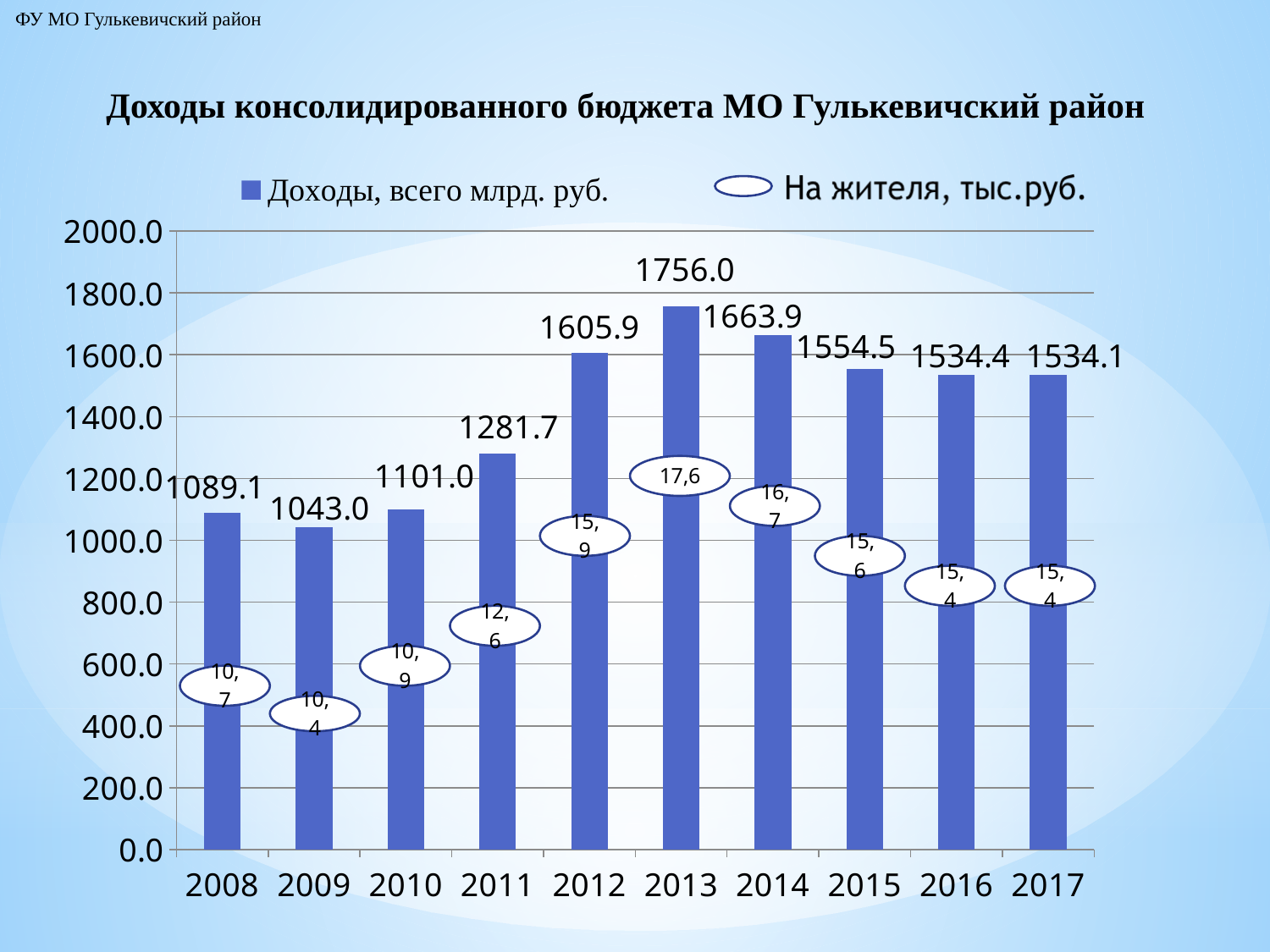
How many series does the legend list? 2 What is the "На жителя, тыс.руб." value shown for 2013? 17,6 What is the value of "Доходы, всего млрд. руб." for 2009? 1043.0 Which year has the larger "Доходы, всего млрд. руб." value, 2011 or 2014? 2014 What is the title of the chart? Доходы консолидированного бюджета МО Гулькевичский район Which year has the highest value of "Доходы, всего млрд. руб."? 2013 What is the "На жителя, тыс.руб." value shown for 2008? 10,7 How many years are shown on the x axis of the chart? 10 What kind of chart is shown on the slide? bar chart What is the difference between the "Доходы, всего млрд. руб." values for 2013 and 2012? 150.1 What is the value of "Доходы, всего млрд. руб." for 2013? 1756.0 Which year has the lowest value of "Доходы, всего млрд. руб."? 2009